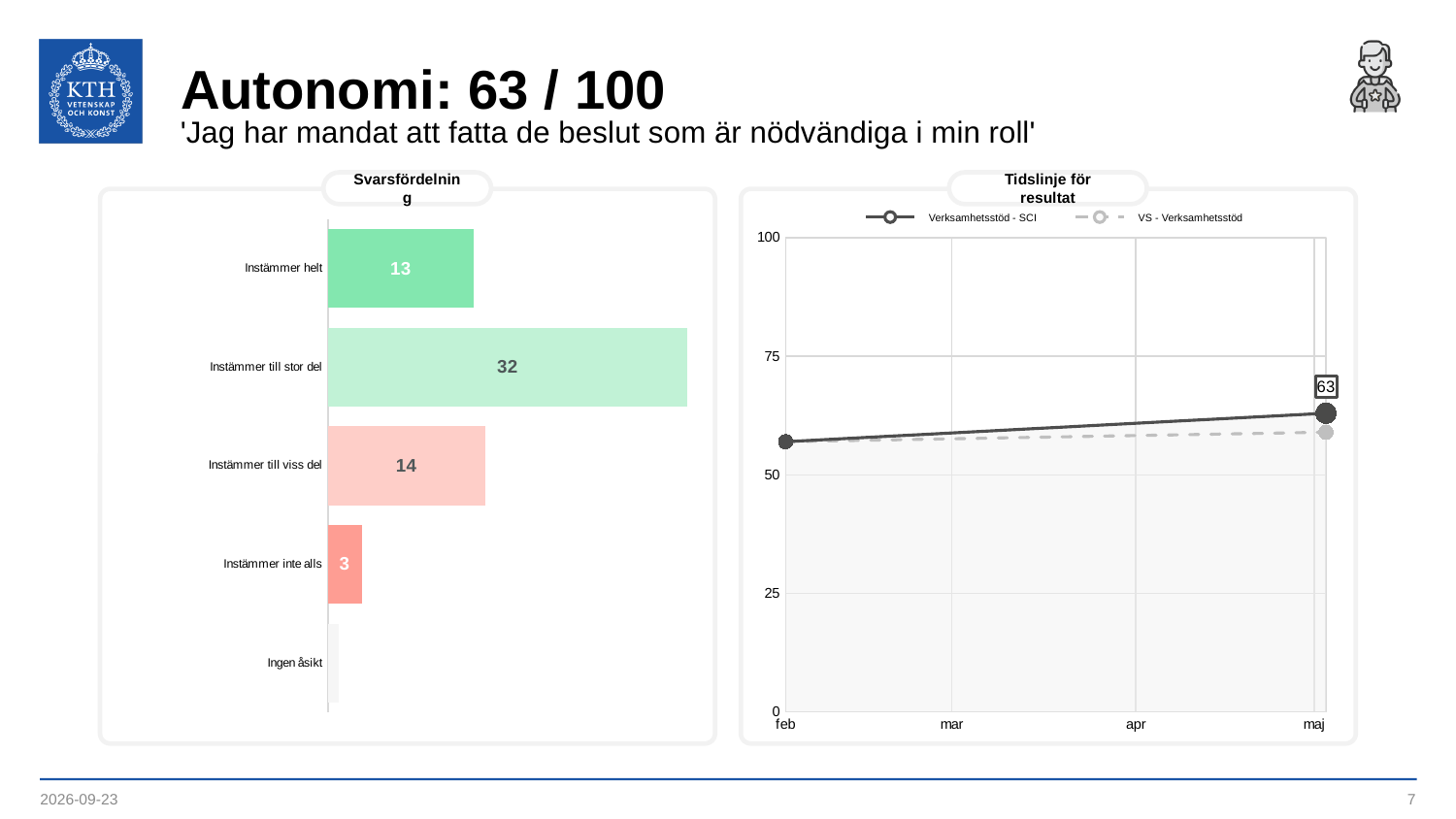
In the Tidslinje för resultat chart, does the Verksamhetsstöd - SCI line rise or fall from feb to maj? rise How many categories are shown in the Svarsfördelning chart? 5 How many series does the legend of the Tidslinje för resultat chart list? 2 In the Svarsfördelning chart, what is the difference between Instämmer till stor del and Instämmer till viss del? 18 In the Tidslinje för resultat chart, what is the value for Verksamhetsstöd - SCI in maj? 63 In the Svarsfördelning chart, which category has the highest value? Instämmer till stor del In the Svarsfördelning chart, what is the value for Instämmer helt? 13 In the Svarsfördelning chart, what is the value for Instämmer till stor del? 32 In the Svarsfördelning chart, what is the value for Instämmer inte alls? 3 In the Svarsfördelning chart, which is larger: Instämmer helt or Instämmer till viss del? Instämmer till viss del In the Tidslinje för resultat chart, is the value for Verksamhetsstöd - SCI in feb greater or less than 75? less What kind of chart is the Svarsfördelning chart? bar chart